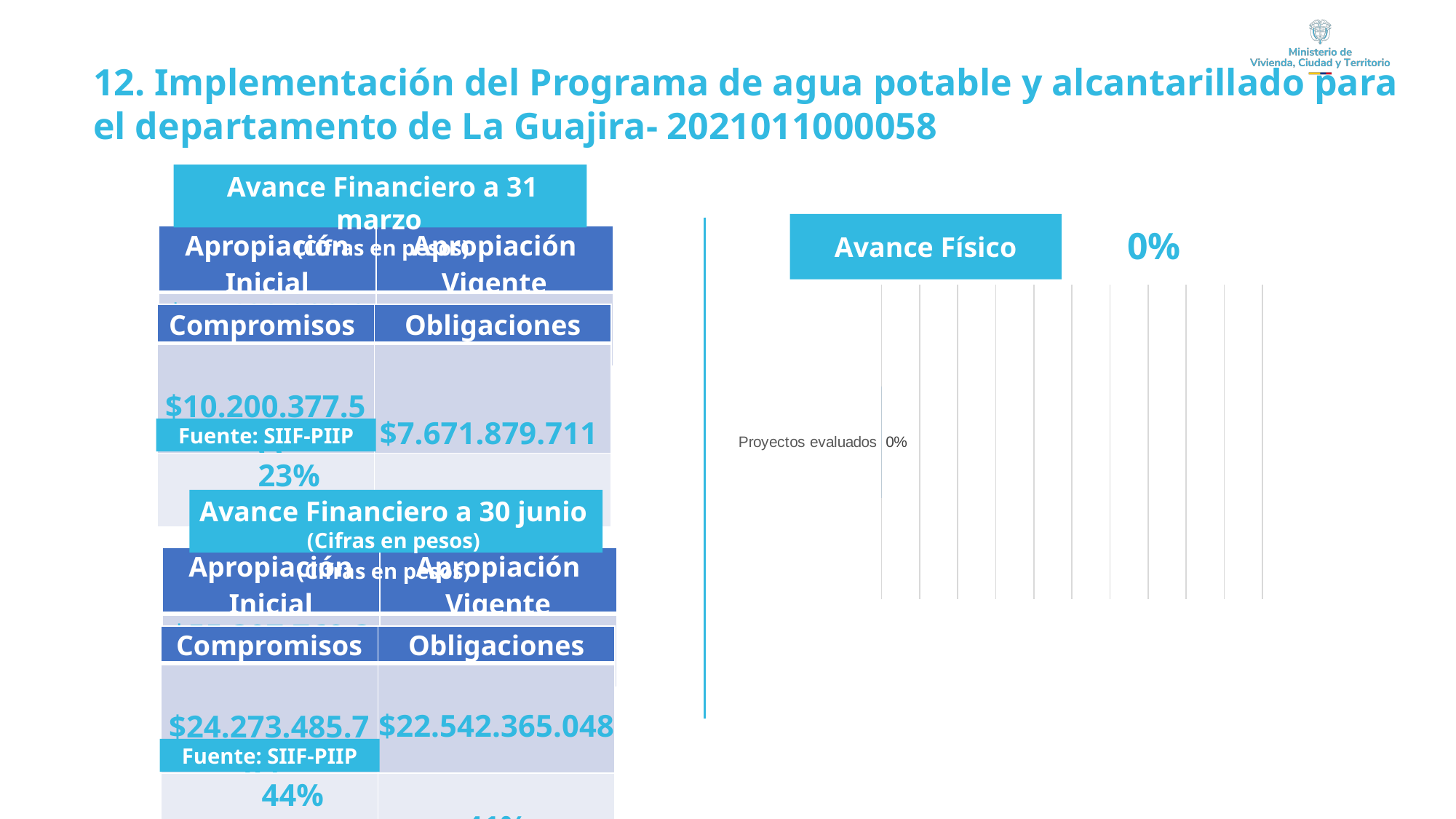
What kind of chart is the Avance Físico chart? bar chart What is the name of the single category plotted in the Avance Físico chart? Proyectos evaluados What is the title of the chart on the right side of the slide? Avance Físico In the Avance Físico chart, what is the value shown for Proyectos evaluados? 0% How many categories are plotted in the Avance Físico chart? 1